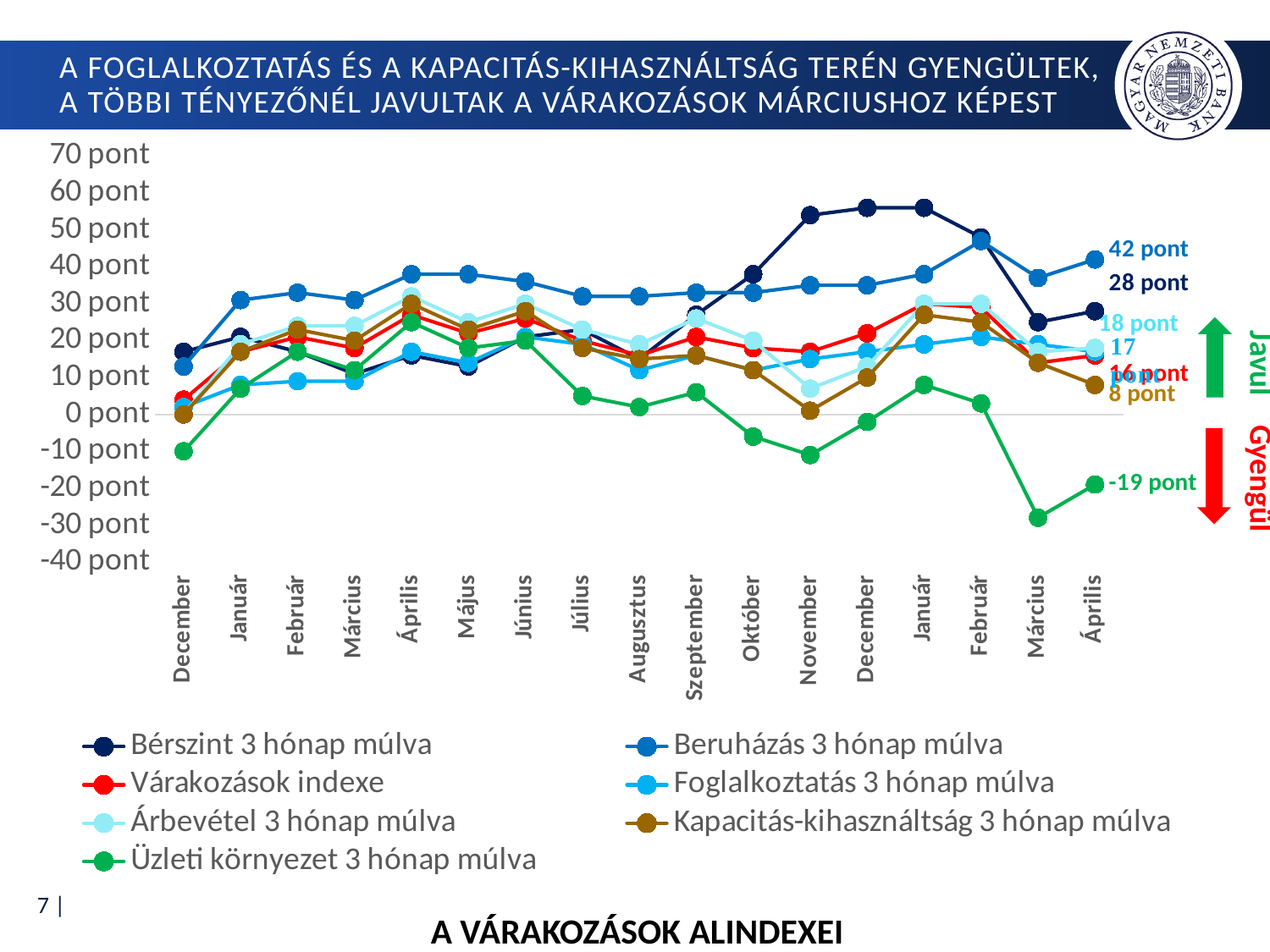
What is the value of Bérszint 3 hónap múlva at the final Április? 28 pont What is the value of Üzleti környezet 3 hónap múlva at the final Április? -19 pont What is the title shown below the chart? A VÁRAKOZÁSOK ALINDEXEI How many months are shown along the x axis? 17 Which series has the highest value at the final Április? Beruházás 3 hónap múlva What is the value of Beruházás 3 hónap múlva at the final Április? 42 pont What is the value of Kapacitás-kihasználtság 3 hónap múlva at the final Április? 8 pont What kind of chart is shown on the slide? line chart Is the value for Bérszint 3 hónap múlva in November greater or less than 50 pont? greater What is the difference between Beruházás 3 hónap múlva and Bérszint 3 hónap múlva at the final Április? 14 pont How many series does the legend list? 7 Which series has the lowest value at the final Április? Üzleti környezet 3 hónap múlva